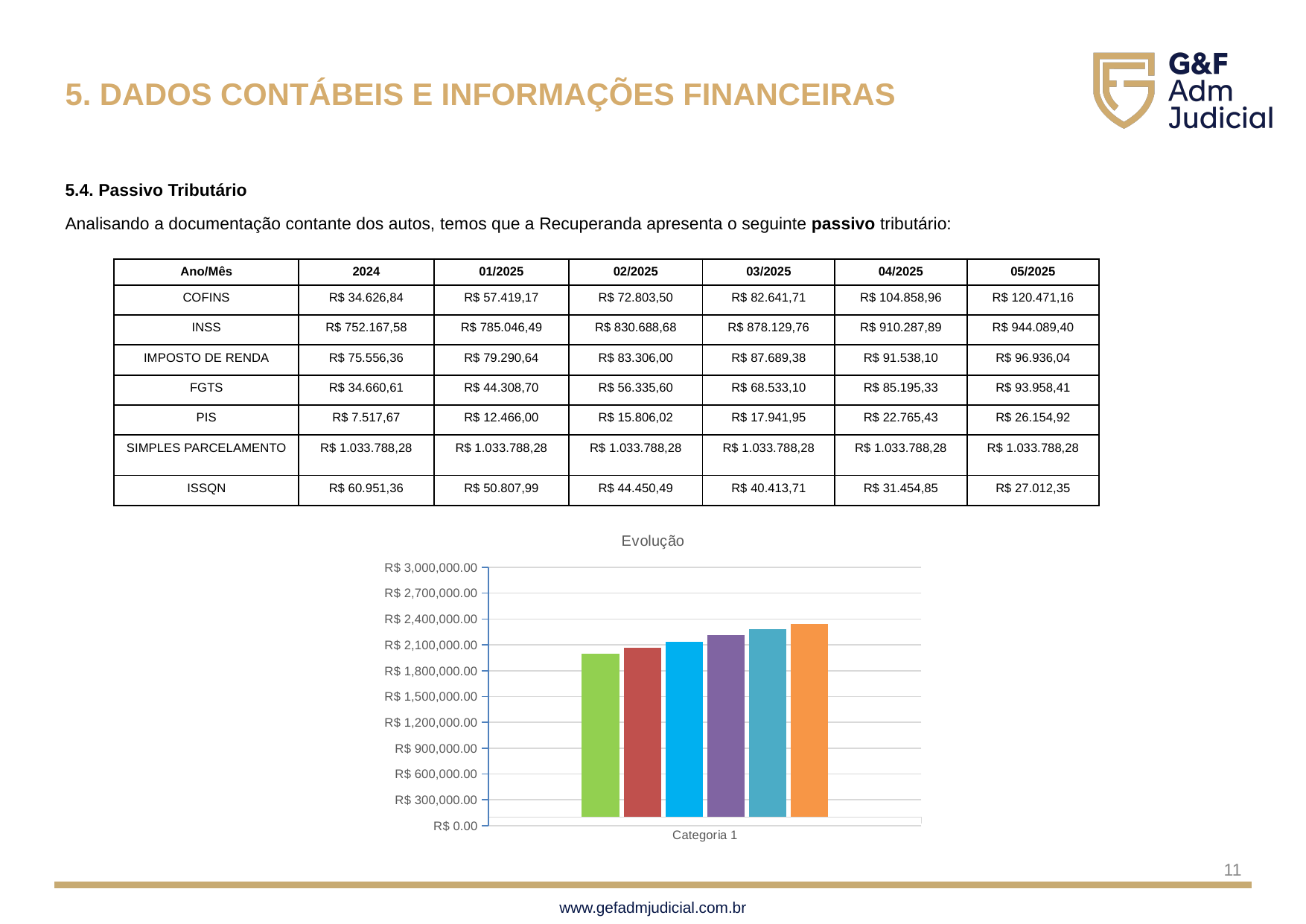
What kind of chart is shown under the title "Evolução"? bar chart In the "Evolução" chart, is the value of the leftmost (green) bar greater or less than R$ 2,100,000.00? less In the "Evolução" chart, which bar has the lowest value? the leftmost (green) bar What is the label shown on the category axis of the "Evolução" chart? Categoria 1 In the "Evolução" chart, is the value of the rightmost (orange) bar greater or less than R$ 2,100,000.00? greater In the "Evolução" chart, do the bars rise or fall from left to right? rise In the "Evolução" chart, which bar is the tallest: the leftmost (green) or the rightmost (orange)? the rightmost (orange) How many bars are plotted in the "Evolução" chart? 6 In the "Evolução" chart, is the value of the rightmost (orange) bar greater or less than R$ 2,700,000.00? less What is the highest value shown on the vertical axis of the "Evolução" chart? R$ 3,000,000.00 What is the title of the chart on the slide? Evolução